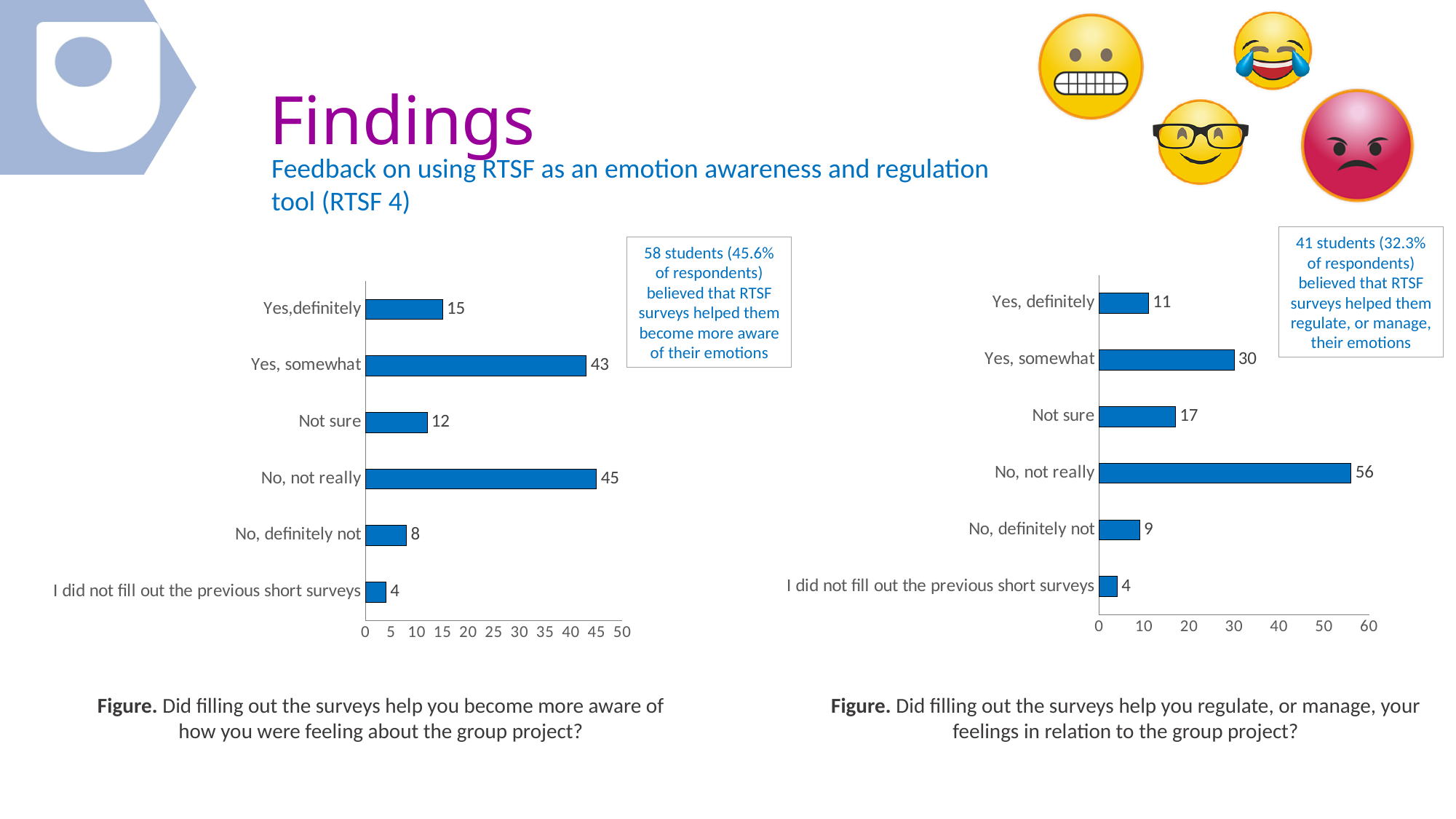
In the left chart (awareness of feelings), which category has the highest value? No, not really How many categories are shown in the left chart (awareness of feelings)? 6 In the right chart (regulate or manage feelings), what is the difference between "No, not really" and "Yes, somewhat"? 26 In the right chart (regulate or manage feelings), is the value for "No, not really" greater or less than 50? greater What type of chart is the right chart (regulate or manage feelings)? Bar chart In the left chart (awareness of feelings), which is larger: "Yes, somewhat" or "No, not really"? No, not really In the right chart (regulate or manage feelings), what is the value for "Yes, definitely"? 11 In the right chart (regulate or manage feelings), what is the value for "Not sure"? 17 In the left chart (awareness of feelings), what is the value for "Yes, somewhat"? 43 In the right chart (regulate or manage feelings), which category has the lowest value? I did not fill out the previous short surveys According to the text box next to the right chart, how many students believed that RTSF surveys helped them regulate, or manage, their emotions? 41 students (32.3% of respondents) In the left chart (awareness of feelings), what is the difference between "Yes,definitely" and "No, definitely not"? 7